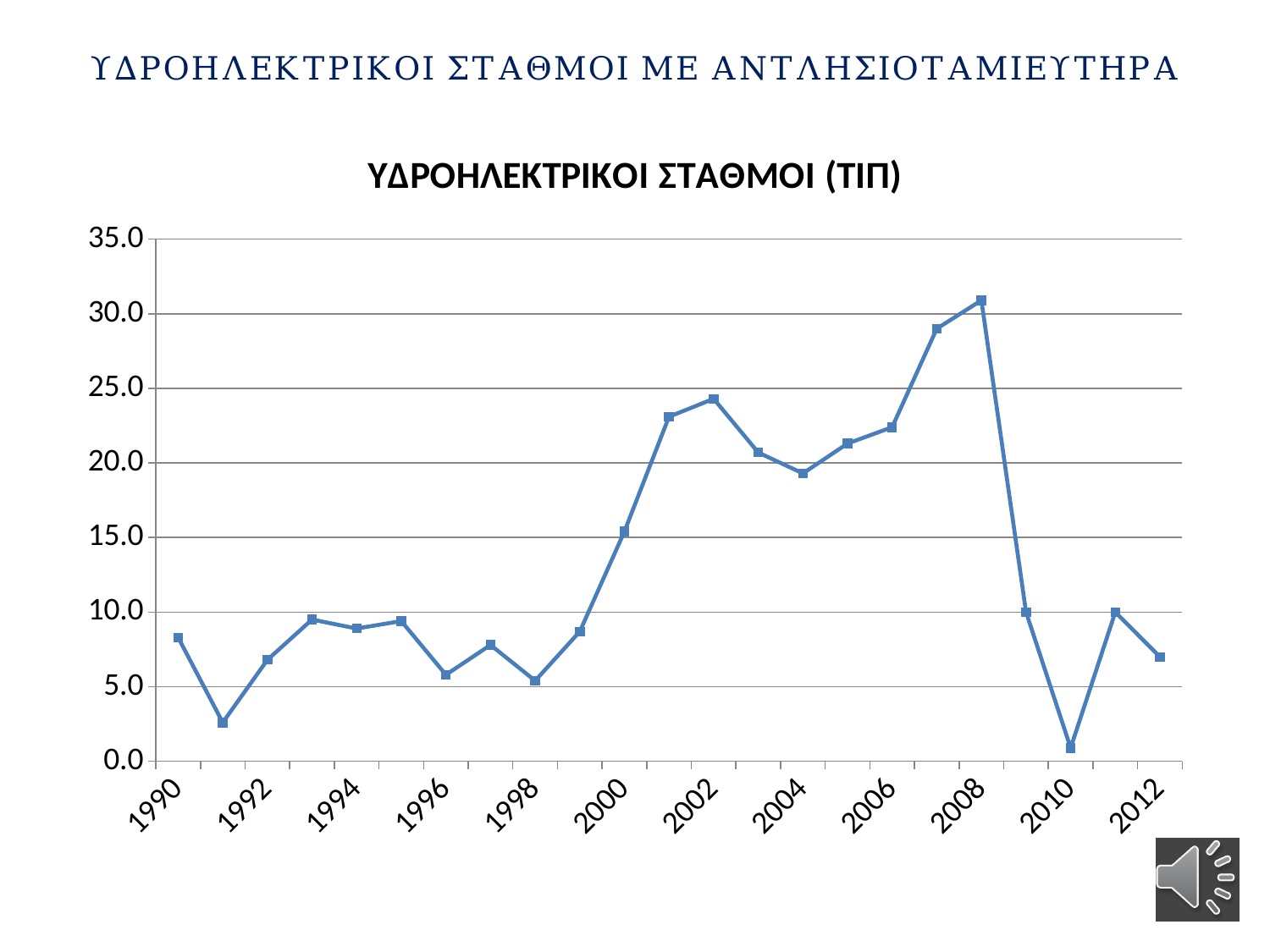
Does the line rise or fall between 2008 and 2010? Fall How many data points are plotted on the line? 23 Which year has the larger value, 1990 or 1991? 1990 What kind of chart is shown on the slide? Line chart In which year does the line reach its lowest value? 2010 What is the title of the chart? ΥΔΡΟΗΛΕΚΤΡΙΚΟΙ ΣΤΑΘΜΟΙ (ΤΙΠ) Which year has the larger value, 2002 or 2004? 2002 Is the value for 2010 greater or less than 5.0? less In which year does the line reach its highest value? 2008 Is the value for 2008 greater or less than 25.0? greater Is the value for 2012 greater or less than 10.0? less